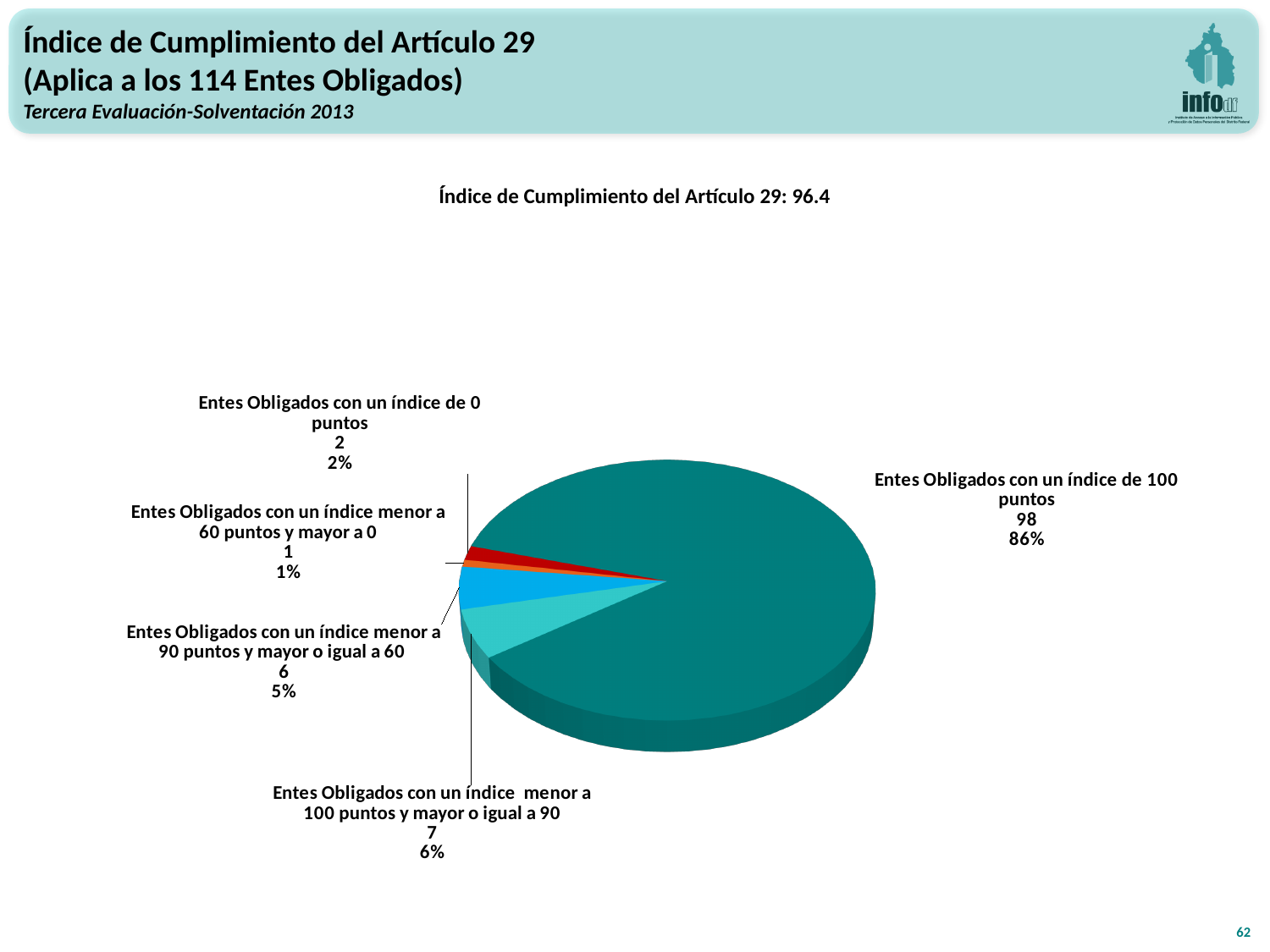
What share of the pie is Entes Obligados con un índice menor a 90 puntos y mayor o igual a 60? 5% How many Entes Obligados have an índice de 100 puntos? 98 What is the Índice de Cumplimiento del Artículo 29 stated above the chart? 96.4 How many categories does the pie chart have? 5 What is the difference between the number of Entes Obligados with an índice de 100 puntos and those with an índice menor a 100 puntos y mayor o igual a 90? 91 How many Entes Obligados have an índice de 0 puntos? 2 What kind of chart is shown on the slide? Pie chart Which is larger: the number of Entes Obligados with an índice de 0 puntos or those with an índice menor a 60 puntos y mayor a 0? Entes Obligados con un índice de 0 puntos What percentage of the pie corresponds to Entes Obligados con un índice de 100 puntos? 86% How many Entes Obligados have an índice menor a 100 puntos y mayor o igual a 90? 7 Which category has the largest slice of the pie? Entes Obligados con un índice de 100 puntos Which category has the smallest slice of the pie? Entes Obligados con un índice menor a 60 puntos y mayor a 0